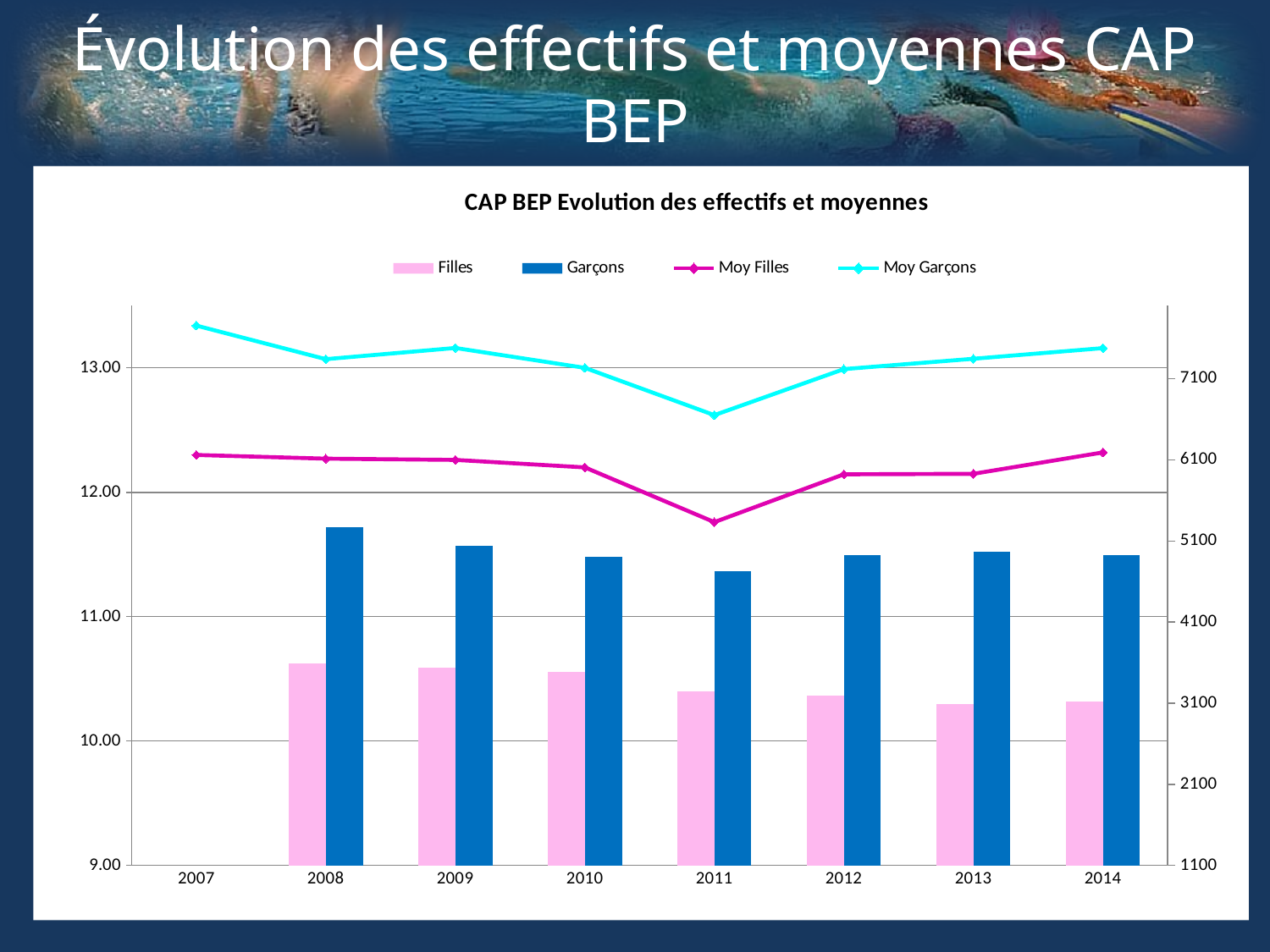
Is the Garçons value for 2011 greater or less than 5100? less Does the Moy Garçons line rise or fall from 2007 to 2011? fall In which year is the Garçons bar the tallest? 2008 How many years are shown on the x axis? 8 In which year is the Moy Filles line at its lowest? 2011 What kind of chart is shown on the slide? A combined bar and line chart Is the Moy Filles value for 2011 greater or less than 12.00? less Is the Moy Garçons value for 2007 greater or less than 13.00? greater Which series is drawn in pink bars? Filles What is the title of the chart? CAP BEP Evolution des effectifs et moyennes How many series does the legend list? 4 In which year is the Moy Garçons line at its lowest? 2011